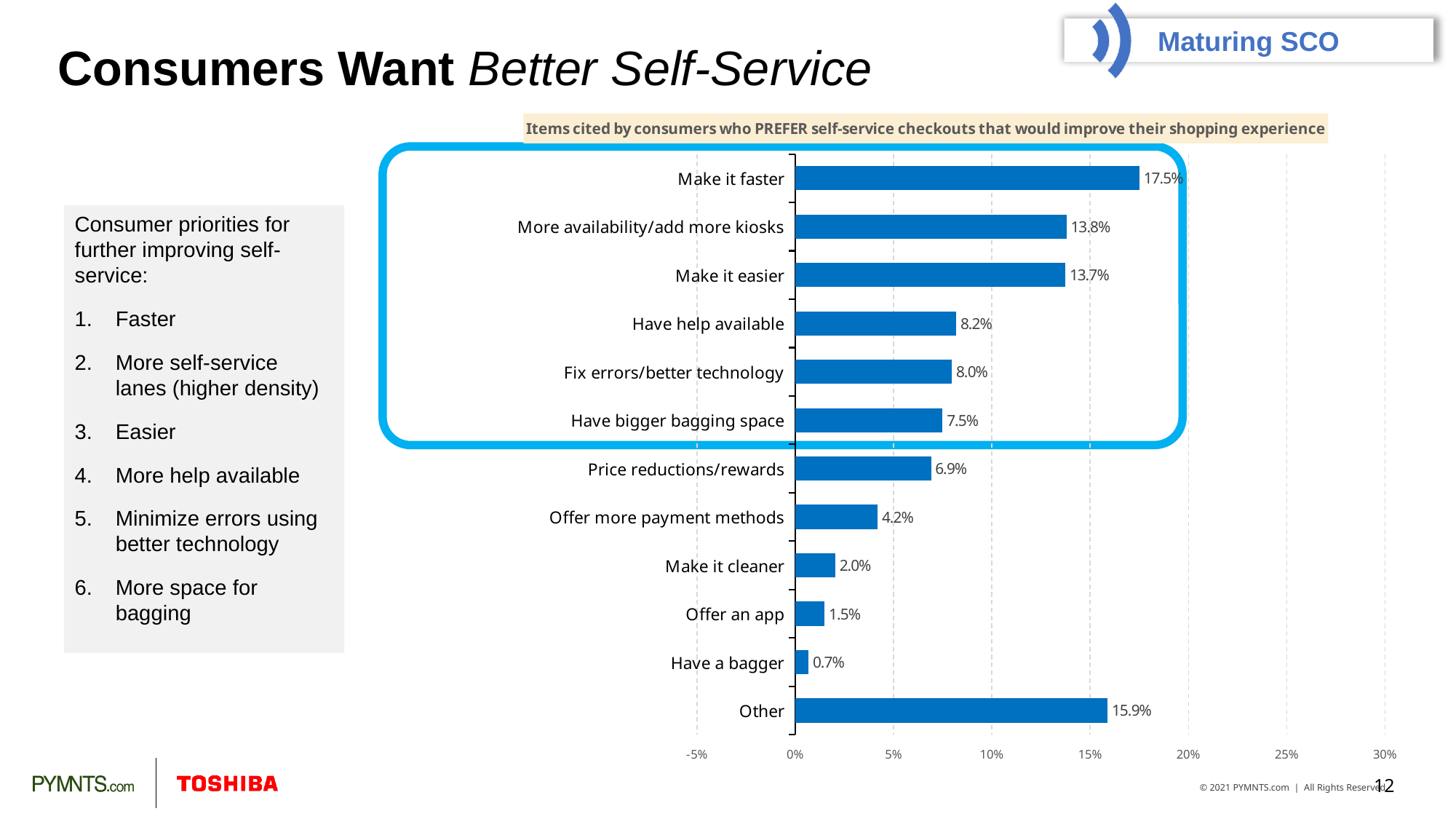
What is the value for "Have help available"? 8.2% Which item has the highest value in the chart? Make it faster What is the value for "Offer an app"? 1.5% Which item has the lowest value in the chart? Have a bagger What is the difference between the values for "Make it cleaner" and "Have a bagger"? 1.3% What percentage of consumers cited "Make it faster" as an item that would improve their shopping experience? 17.5% What kind of chart is shown on the slide? Bar chart Is the value for "Other" greater or less than 15%? greater Which has a larger value: "Price reductions/rewards" or "Offer more payment methods"? Price reductions/rewards What is the difference between the values for "Make it faster" and "Make it easier"? 3.8% How many items (categories) are shown in the chart? 12 What is the title of the chart? Items cited by consumers who PREFER self-service checkouts that would improve their shopping experience